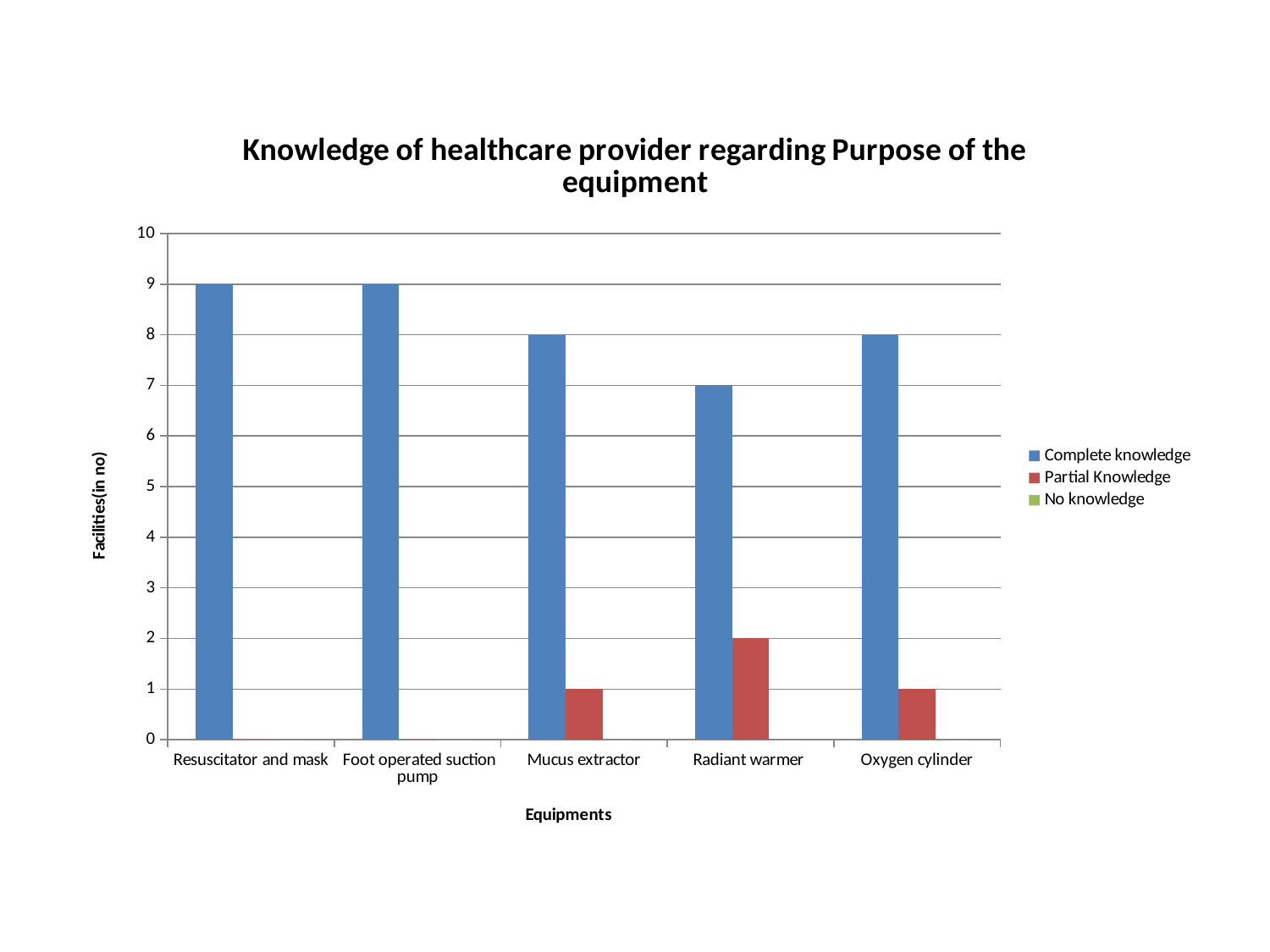
What is the title of the y axis? Facilities(in no) What is the difference between the Complete knowledge values for Foot operated suction pump and Mucus extractor? 1 What type of chart is shown on the slide? Bar chart What is the Complete knowledge value for Resuscitator and mask? 9 Which equipment has the highest Partial Knowledge value? Radiant warmer Which equipment has the lowest Complete knowledge value? Radiant warmer Is the Complete knowledge value for Oxygen cylinder greater or less than the Complete knowledge value for Radiant warmer? greater What is the Complete knowledge value for Radiant warmer? 7 How many equipment categories are shown on the x axis? 5 What is the Partial Knowledge value for Radiant warmer? 2 What is the Partial Knowledge value for Oxygen cylinder? 1 How many series does the legend list? 3